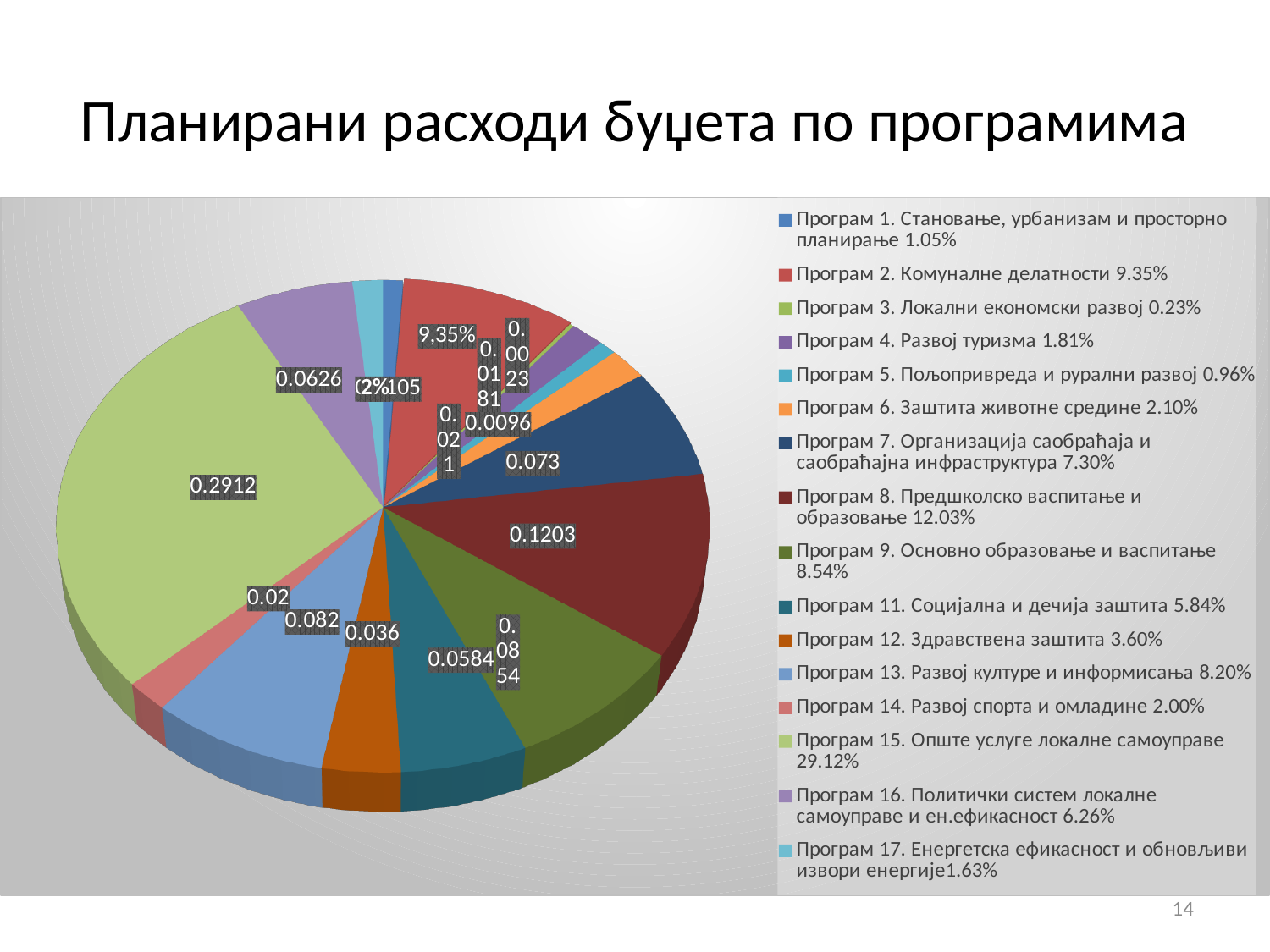
Which program has the smallest share of the budget? Програм 3. Локални економски развој Which has a larger share: Програм 2. Комуналне делатности or Програм 9. Основно образовање и васпитање? Програм 2. Комуналне делатности What is the difference in percentage points between the shares of Програм 15 (29.12%) and Програм 8 (12.03%)? 17.09 What share of the budget is planned for Програм 7. Организација саобраћаја и саобраћајна инфраструктура? 7.30% How many programs does the legend list? 16 What share of the budget is planned for Програм 13. Развој културе и информисања? 8.20% What colour is the slice for Програм 15. Опште услуге локалне самоуправе? light green Which program has the largest share of the budget? Програм 15. Опште услуге локалне самоуправе What is the title of the chart? Планирани расходи буџета по програмима What share of the budget is planned for Програм 2. Комуналне делатности? 9.35% What share of the budget is planned for Програм 8. Предшколско васпитање и образовање? 12.03% What kind of chart is shown on the slide? pie chart